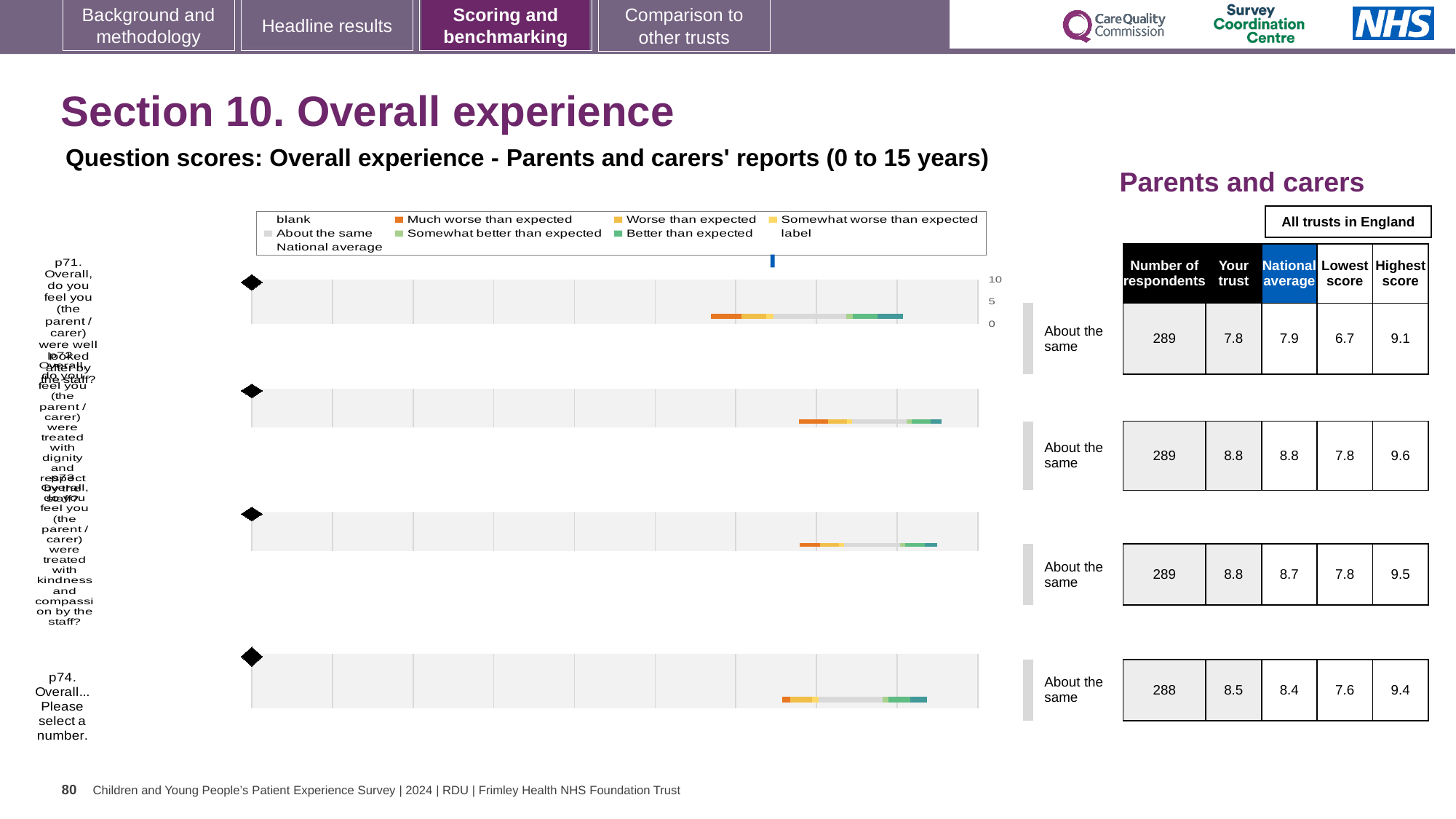
How many question rows (bars) are plotted in the chart? 4 For p74, which is larger: the 'Your trust' score or the national average? Your trust What is the difference between the highest score and the lowest score for p71? 2.4 What is the maximum value shown on the chart's score axis? 10 What benchmark category is shown next to each of the four question rows? About the same What kind of chart is shown on the slide? bar chart In the table, how many respondents are listed for p74 (Overall... Please select a number)? 288 What colour does the legend use for 'Much worse than expected'? orange In the table, what is the national average for p74? 8.4 In the table, what is the 'Your trust' score for p71 (Overall, do you feel you were well looked after by the staff)? 7.8 Which question row has the lowest 'Your trust' score in the table? p71 In the table, what is the lowest score for p71? 6.7